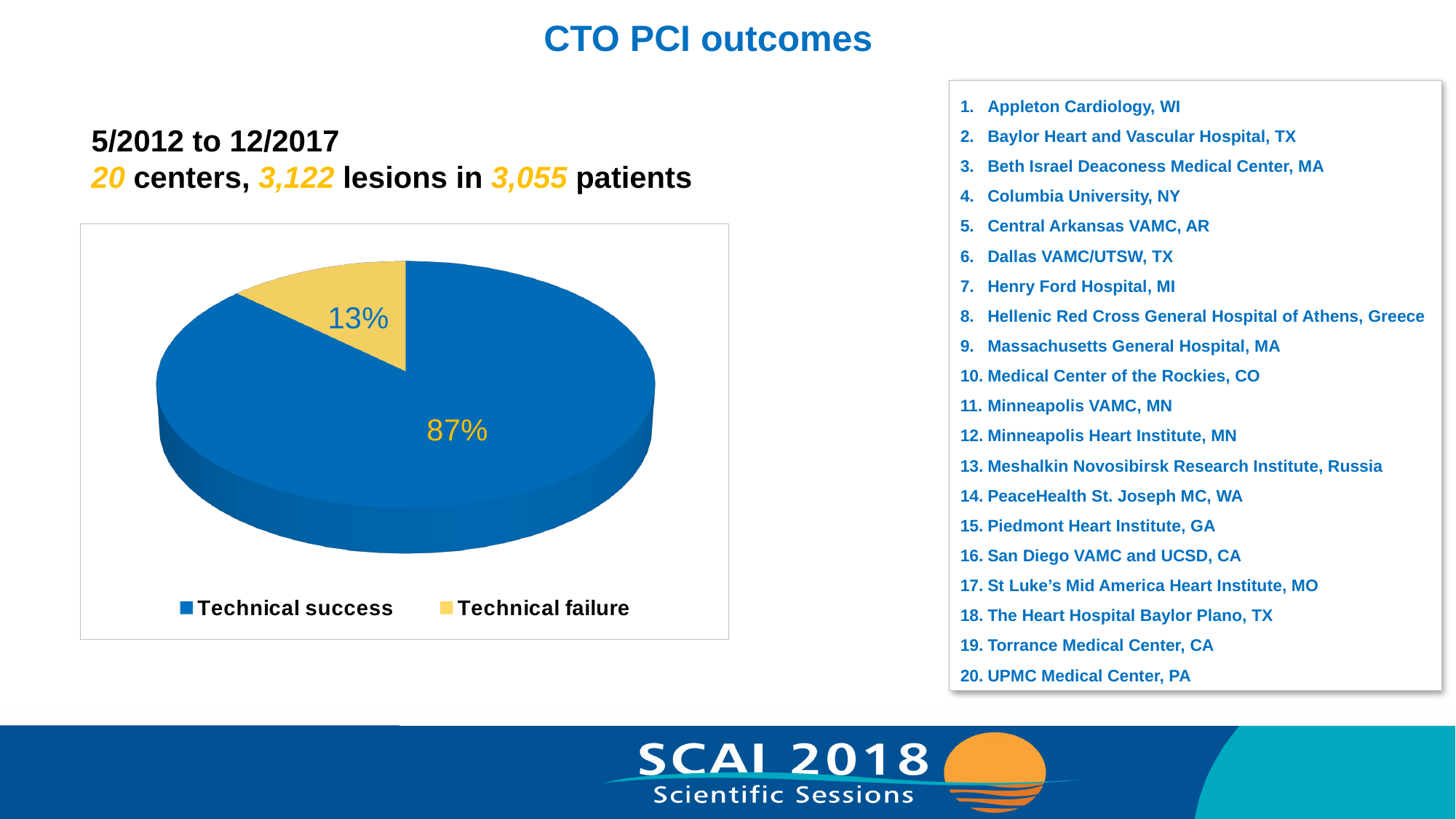
What percentage of the pie is Technical success? 87% Which is larger, Technical success or Technical failure? Technical success How many entries does the legend list? 2 What colour is the Technical success slice? Blue What percentage of the pie is Technical failure? 13% What is the difference in percentage points between Technical success and Technical failure? 74 How many slices does the pie chart have? 2 Which slice of the pie is the largest? Technical success Which slice of the pie is the smallest? Technical failure Is the value for Technical success greater or less than 50%? greater What kind of chart is shown on the slide? Pie chart What colour is the Technical failure slice? Yellow